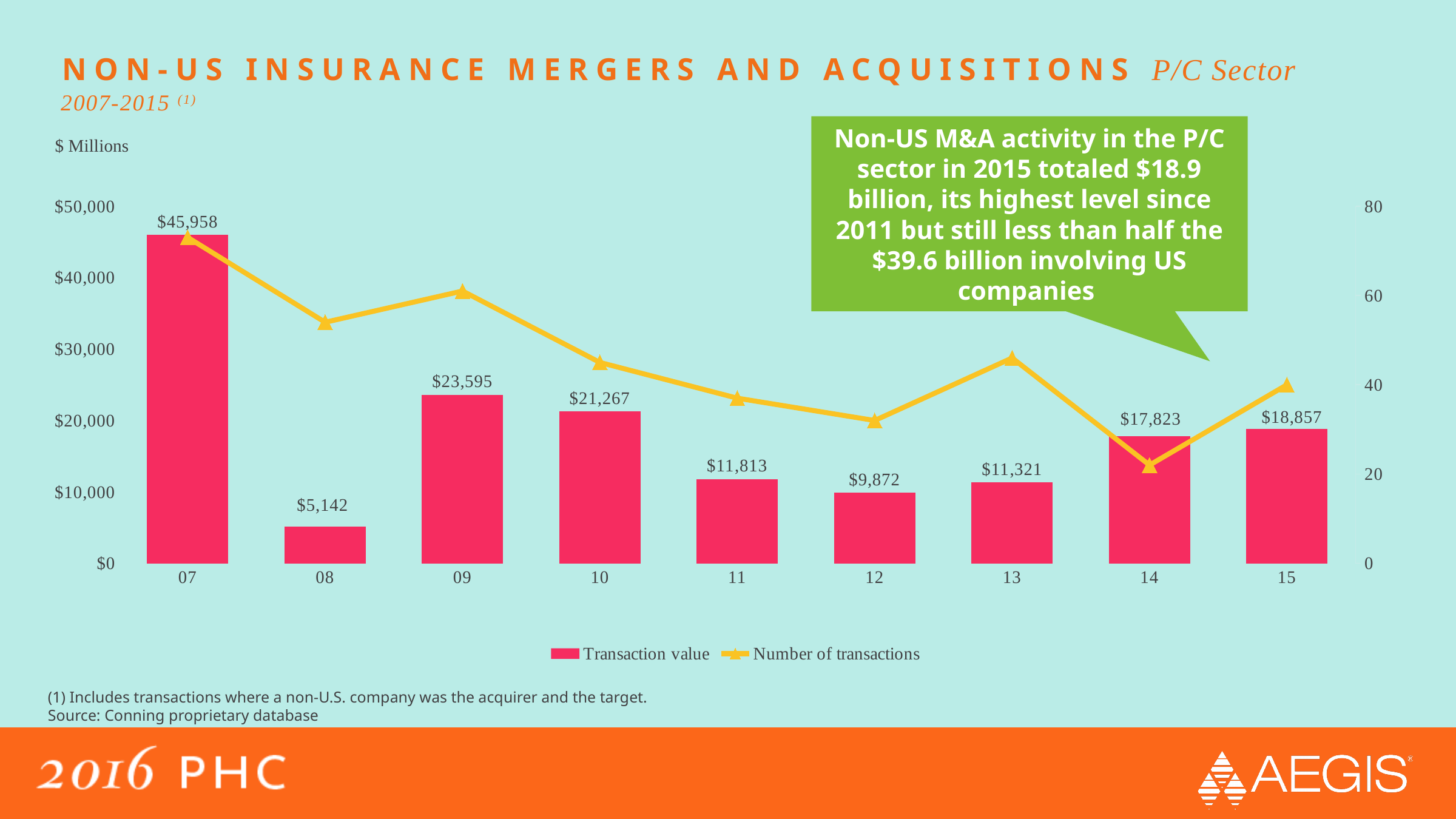
Which year has the lowest transaction value? 08 What is the transaction value for 2014? $17,823 What kind of chart is shown on the slide? Combined bar and line chart What is the transaction value for 2009? $23,595 How many series does the legend list? 2 Does the number of transactions rise or fall from 2007 to 2008? fall How many years are shown on the x axis? 9 Is the number of transactions in 2007 greater or less than 60? greater Which year has the highest transaction value? 07 Which year has the larger transaction value, 2009 or 2010? 09 What is the difference between the transaction value in 2015 and in 2014? $1,034 Is the number of transactions in 2014 greater or less than 40? less